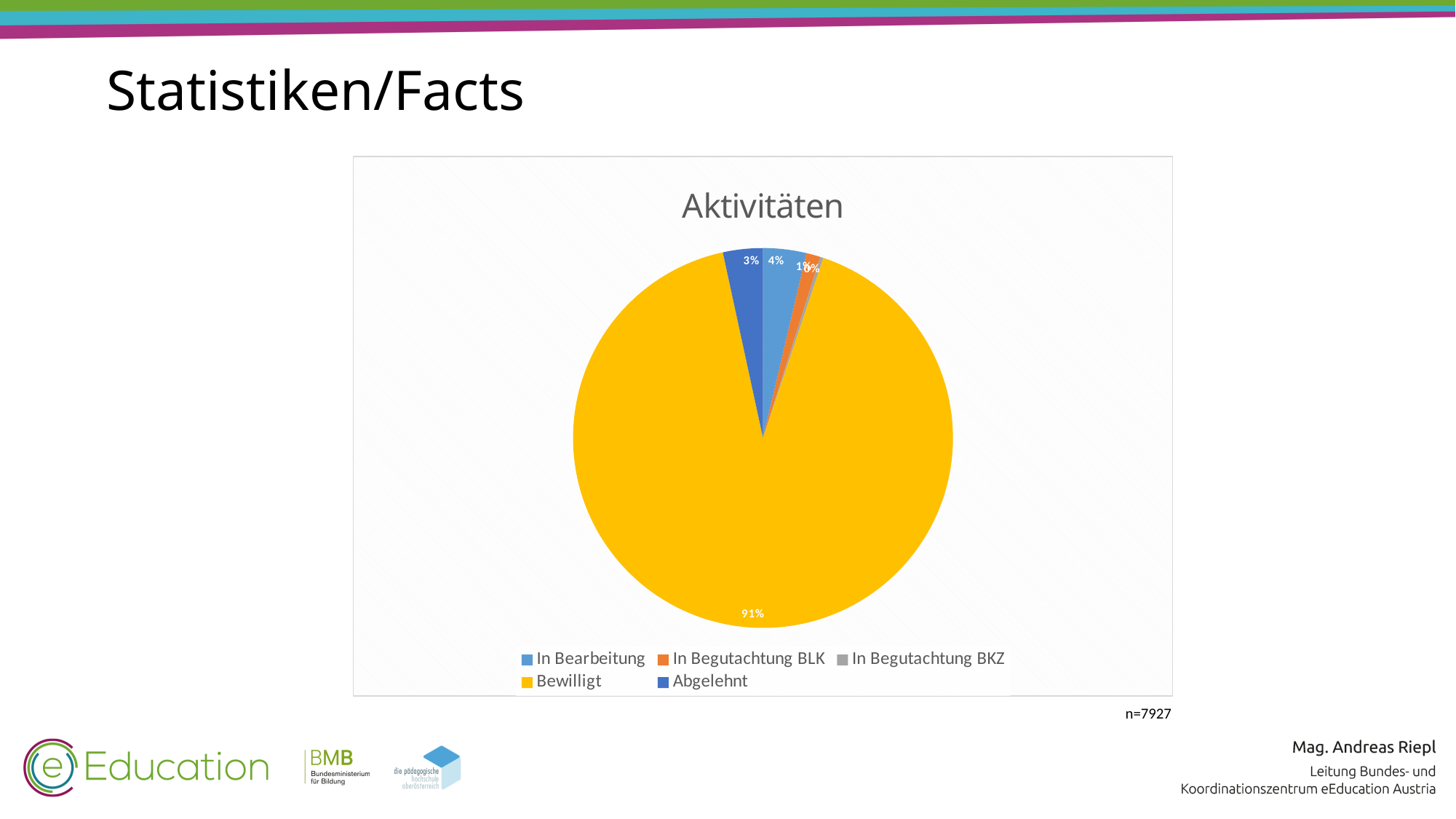
Which category has the largest slice of the pie? Bewilligt What share of the pie does Bewilligt have? 91% What is the title of the chart? Aktivitäten How many categories does the legend list? 5 What share of the pie does In Bearbeitung have? 4% Which category has the smallest slice of the pie? In Begutachtung BKZ What is the difference in percentage points between the Bewilligt share and the In Bearbeitung share? 87 What share of the pie does In Begutachtung BLK have? 1% Which is larger, the share for In Bearbeitung or the share for Abgelehnt? In Bearbeitung What kind of chart is shown on the slide? pie chart What colour is the Bewilligt slice? yellow